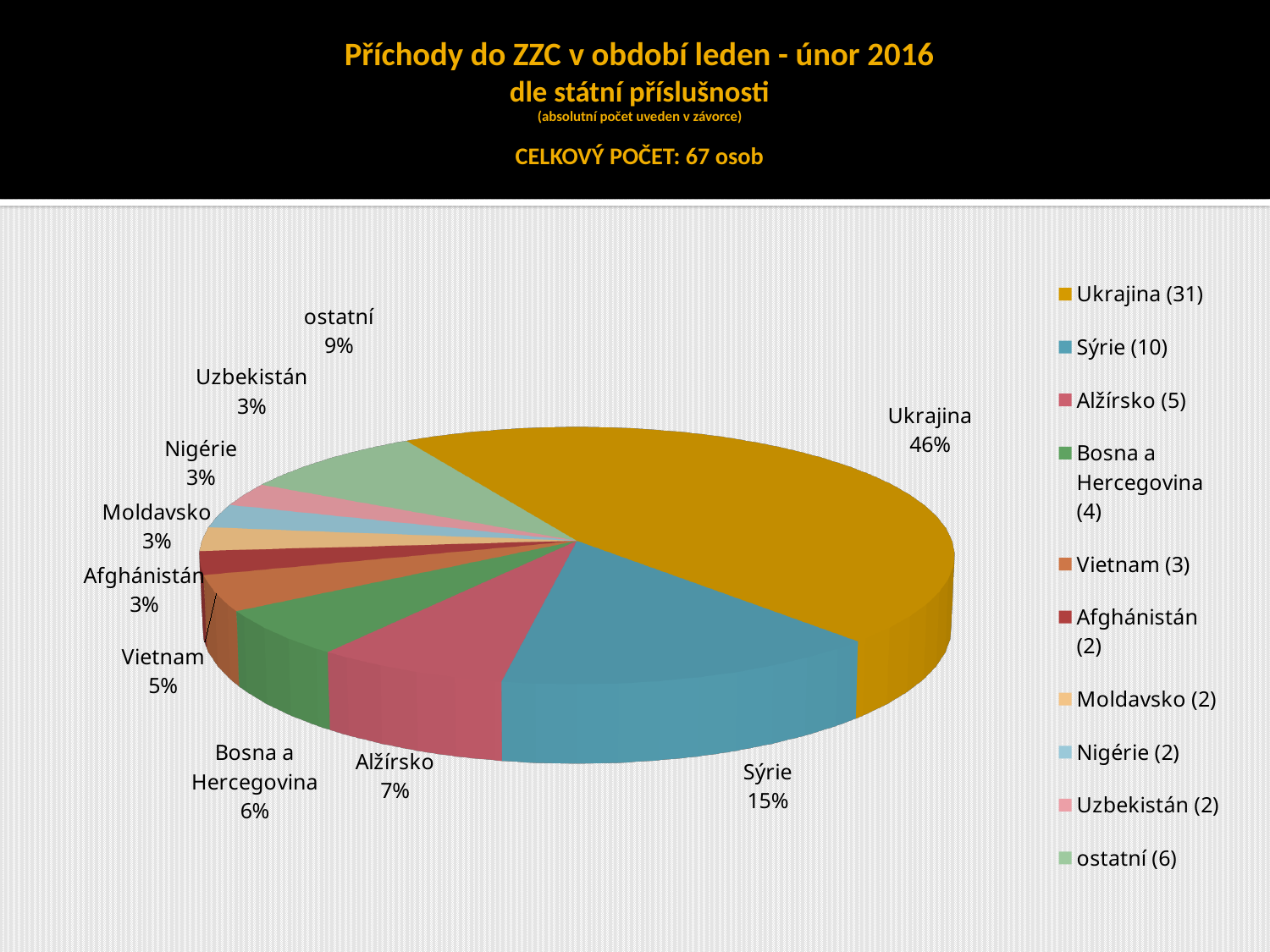
What is the absolute count shown in the legend for Sýrie? 10 How many categories does the legend list? 10 What kind of chart is shown on the slide? Pie chart Which category has the largest slice of the pie? Ukrajina What is the absolute count shown in the legend for Ukrajina? 31 What is the difference in percentage points between the Ukrajina and Sýrie slices? 31% What share of the pie does Bosna a Hercegovina represent? 6% What share of the pie does Sýrie represent? 15% What share of the pie does the 'ostatní' slice represent? 9% Which slice is larger, Alžírsko or Vietnam? Alžírsko